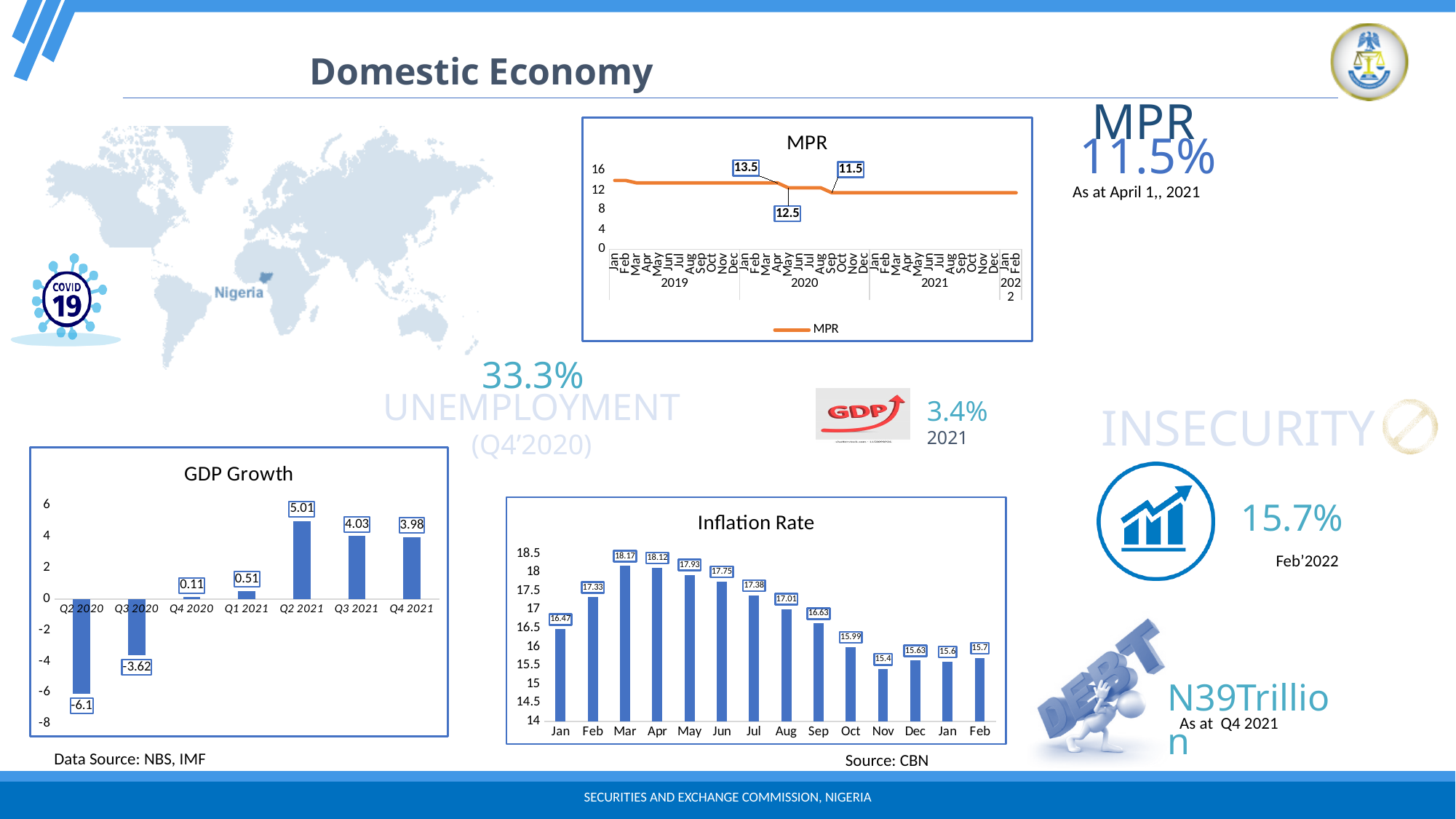
In the Inflation Rate chart, which is larger, the value for Feb (first) or the value for Aug? Feb What kind of chart is the MPR chart? line chart In the GDP Growth chart, what is the difference between the values for Q2 2021 and Q4 2021? 1.03 In the Inflation Rate chart, what is the value for Mar? 18.17 In the GDP Growth chart, how many quarters are plotted? 7 In the MPR chart, what is the lowest labelled value of the MPR line? 11.5 In the GDP Growth chart, which quarter has the highest value? Q2 2021 In the Inflation Rate chart, which month has the lowest value? Nov In the GDP Growth chart, which quarter has the lowest value? Q2 2020 In the Inflation Rate chart, how many bars are plotted? 14 In the GDP Growth chart, what is the value for Q2 2021? 5.01 In the Inflation Rate chart, what is the difference between the values for Mar and Nov? 2.77